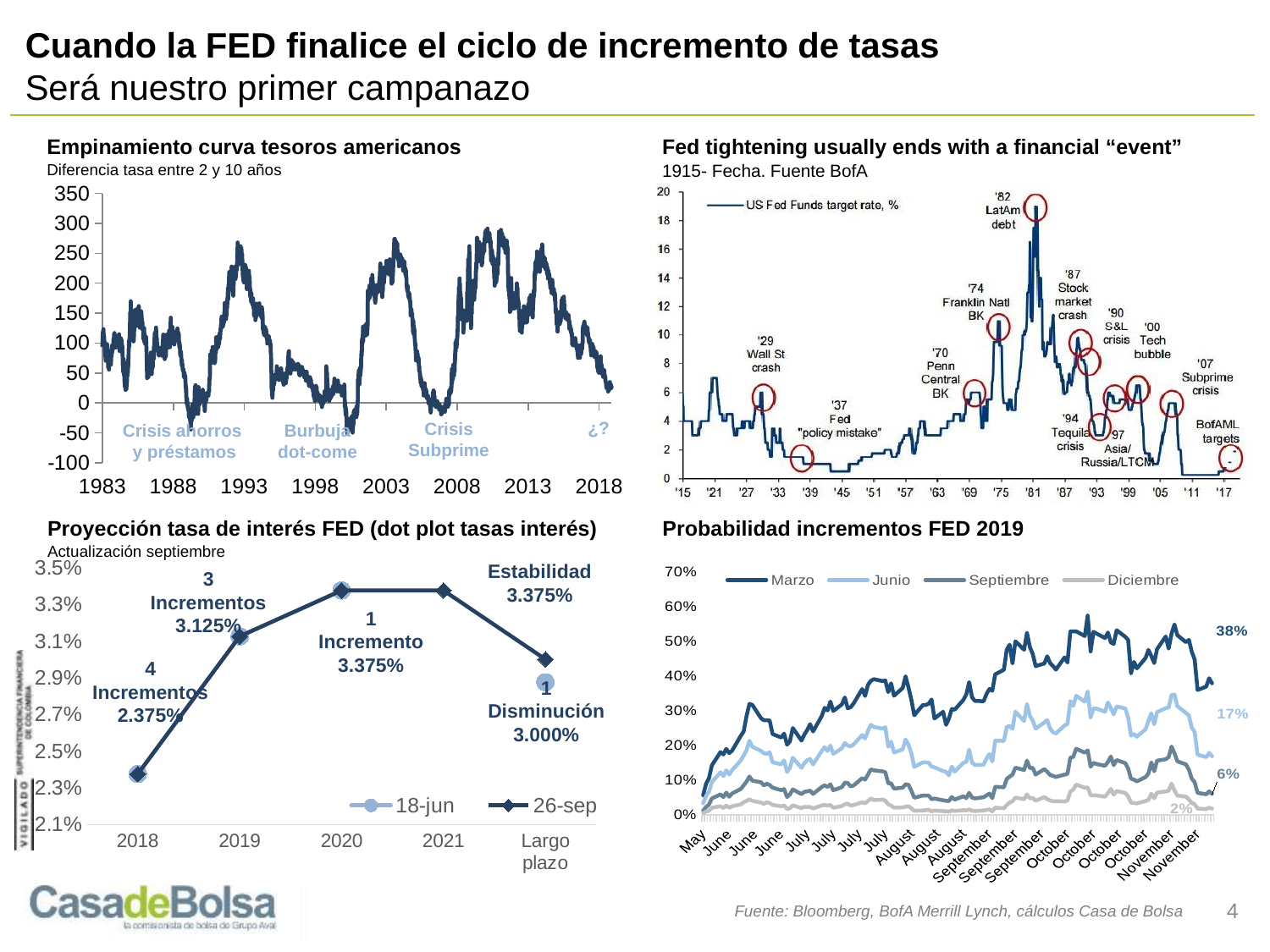
In the 'Proyección tasa de interés FED' chart, what is the 26-sep projected rate for 2018? 2.375% In the 'Proyección tasa de interés FED' chart, how many rate increases are labelled for 2018? 4 Incrementos In the 'Probabilidad incrementos FED 2019' chart, how many series does the legend list? 4 What kind of chart is 'Empinamiento curva tesoros americanos'? line chart In the 'Proyección tasa de interés FED' chart, what is the 26-sep projected rate for 'Largo plazo'? 3.000% In the 'Proyección tasa de interés FED' chart, what is the 26-sep projected rate for 2019? 3.125% In the 'Probabilidad incrementos FED 2019' chart, what is the difference between the final labelled values of Marzo and Junio? 21% In the 'Probabilidad incrementos FED 2019' chart, which series has the lowest final labelled value? Diciembre In the 'Probabilidad incrementos FED 2019' chart, what is the final labelled value for the Marzo series? 38% In the 'Proyección tasa de interés FED' chart, how many categories are shown on the x axis? 5 In the 'Proyección tasa de interés FED' chart, how many series does the legend list? 2 In the 'Probabilidad incrementos FED 2019' chart, is the peak value of the Marzo series greater or less than 50%? greater